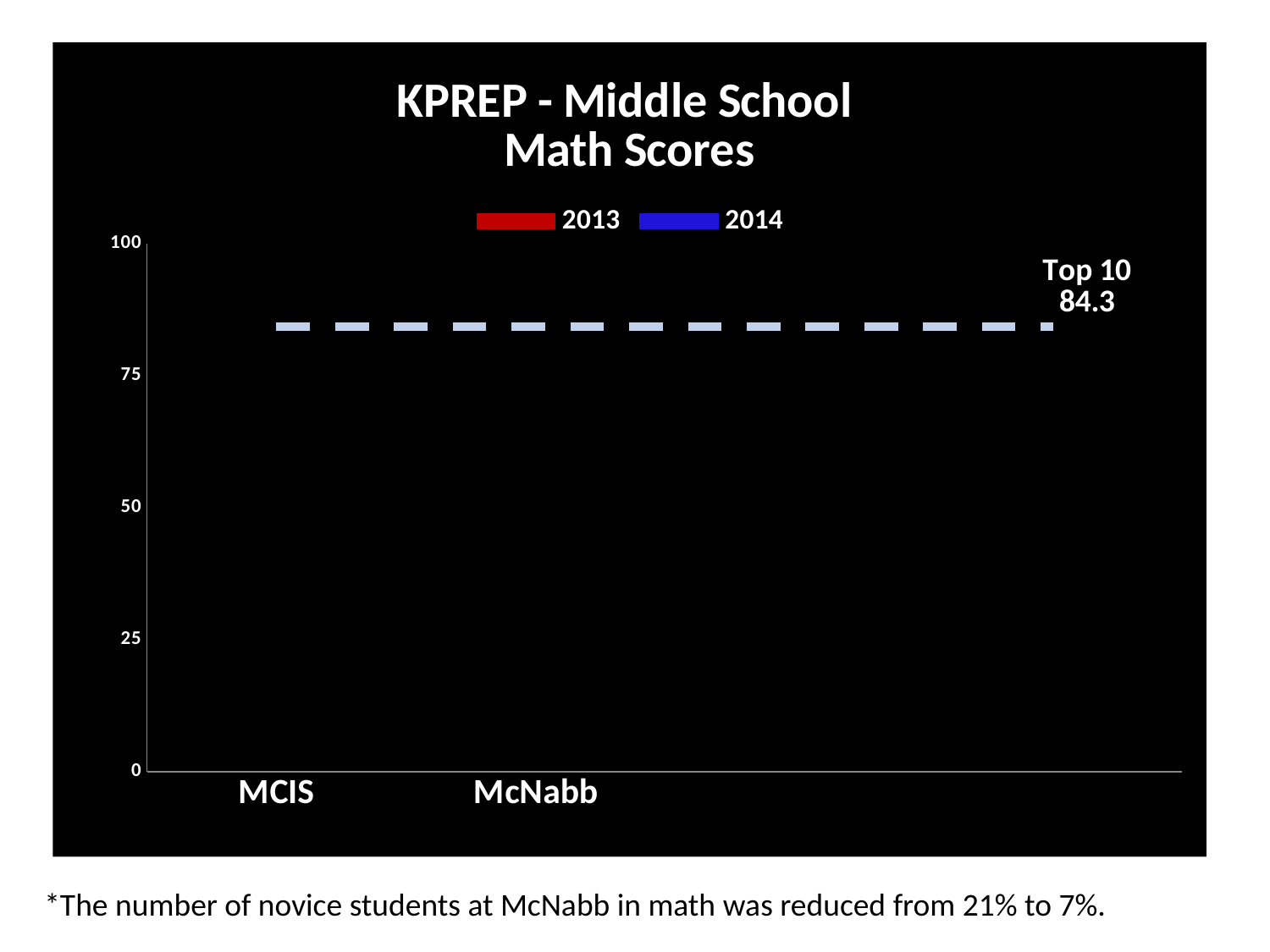
Is the 'Top 10' reference line greater or less than 100? less What are the two category labels on the x axis? MCIS and McNabb What is the highest value shown on the y axis? 100 Which years are listed in the chart's legend? 2013 and 2014 Is the 'Top 10' reference line greater or less than 75? greater What value does the dashed 'Top 10' reference line mark? 84.3 How many categories are labelled on the x axis? 2 How many series does the legend list? 2 What is the title of the chart? KPREP - Middle School Math Scores